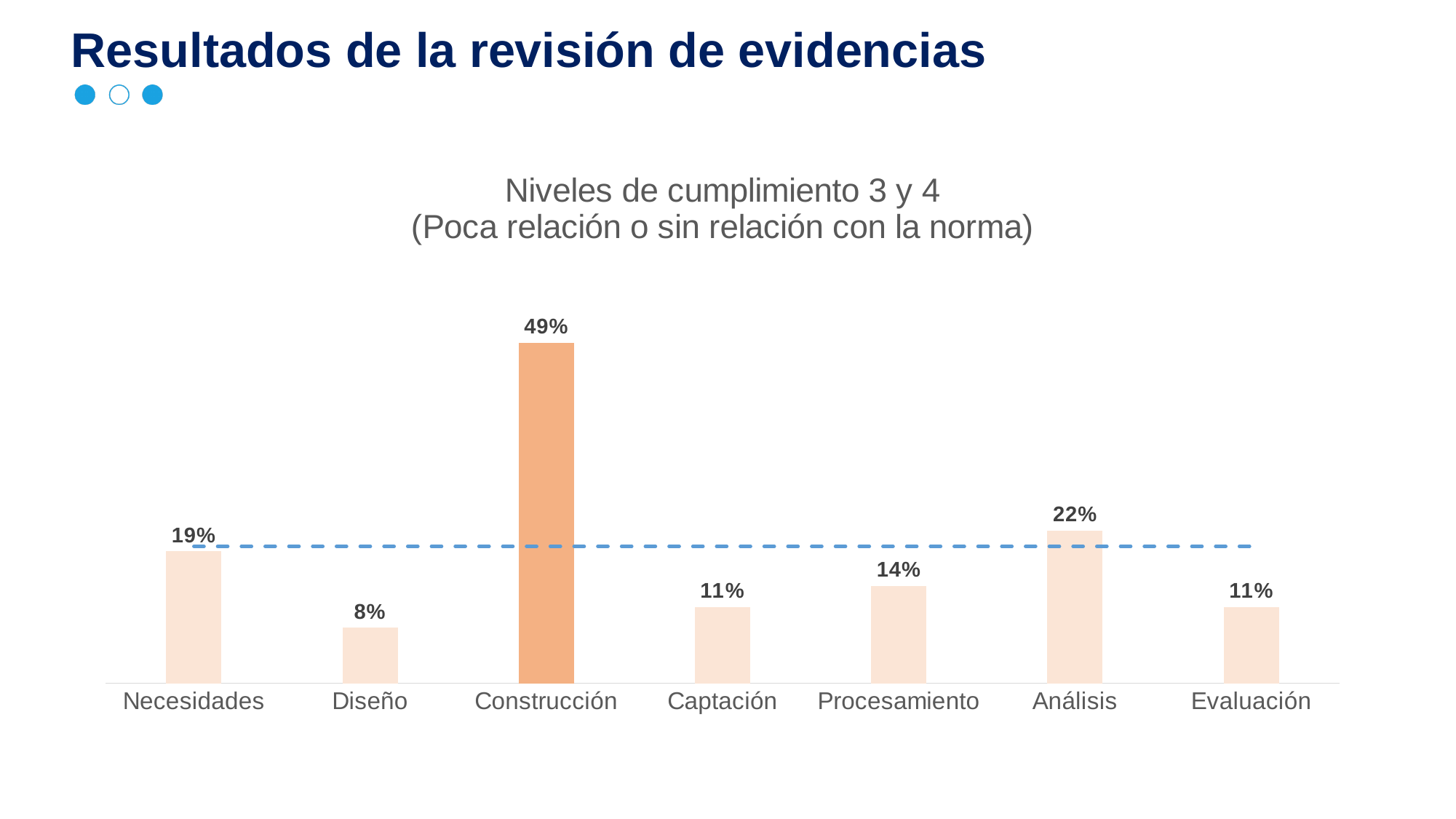
Which category has the lowest value? Diseño What is the title of the chart? Niveles de cumplimiento 3 y 4 (Poca relación o sin relación con la norma) What is the difference between the values for Necesidades and Diseño? 11% What is the value for Diseño? 8% What is the value for Análisis? 22% What is the difference between the values for Construcción and Análisis? 27% Which category has the highest value? Construcción How many categories are shown on the x axis? 7 What is the value for Construcción? 49% What kind of chart is shown on the slide? Bar chart What is the value for Procesamiento? 14% Which is larger, the value for Necesidades or the value for Procesamiento? Necesidades